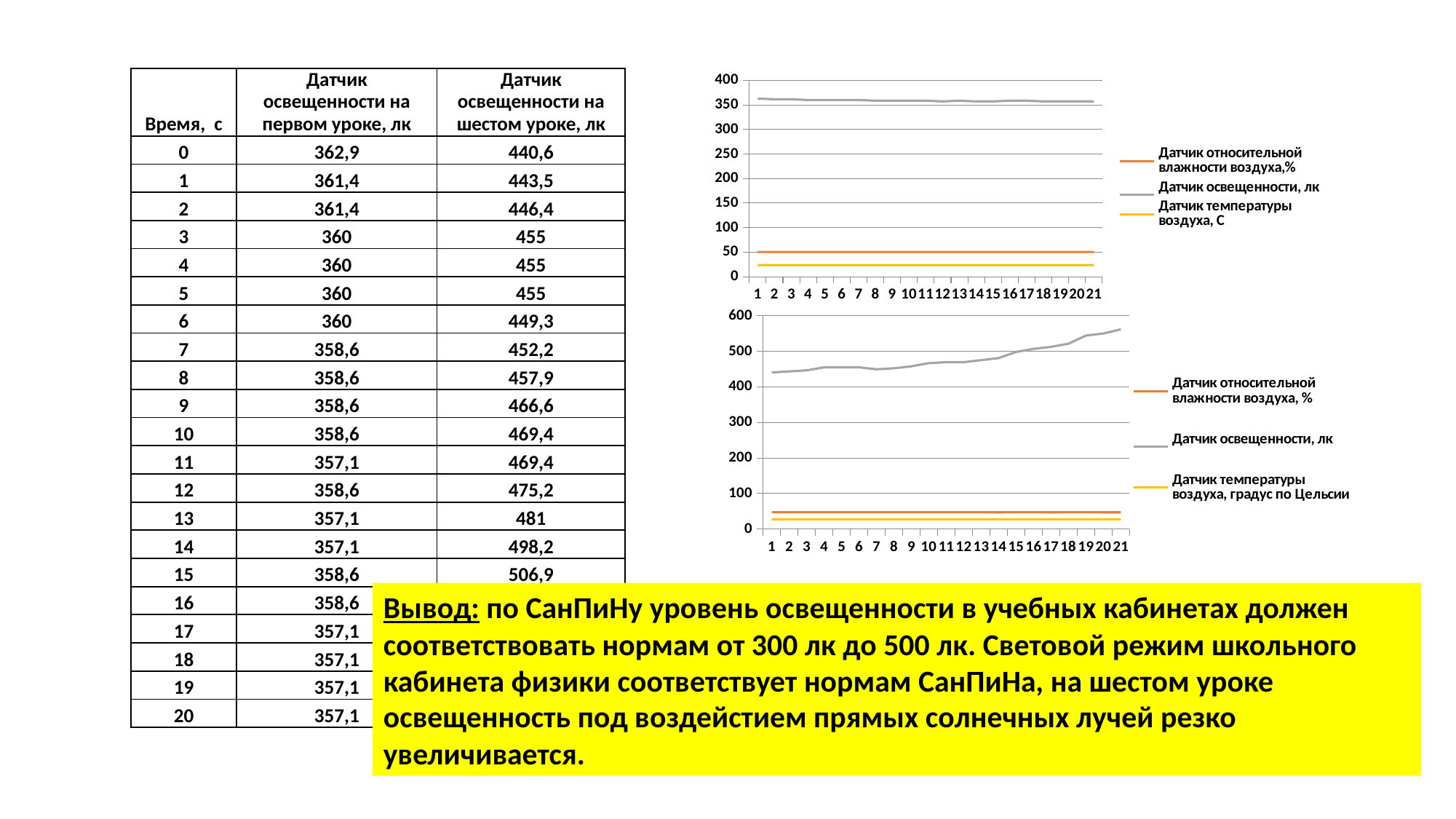
What kind of chart is the top chart on the right of the slide? Line chart In the top chart, which series has the highest values? Датчик освещенности, лк How many series does the legend of the top chart list? 3 In the bottom chart, do the values of the series 'Датчик освещенности, лк' rise or fall from point 1 to point 21? rise In the top chart, is the value of the series 'Датчик освещенности, лк' at point 1 greater or less than 300? greater In the top chart, is the value of the series 'Датчик относительной влажности воздуха,%' at point 10 greater or less than 100? less In the bottom chart, which is larger for the series 'Датчик освещенности, лк': the value at point 1 or the value at point 21? point 21 In the bottom chart, which series is drawn in gray according to the legend? Датчик освещенности, лк In the bottom chart, is the value of the series 'Датчик освещенности, лк' at point 21 greater or less than 500? greater How many points are on the x axis of the bottom chart? 21 In the top chart, which series has the lowest values? Датчик температуры воздуха, С